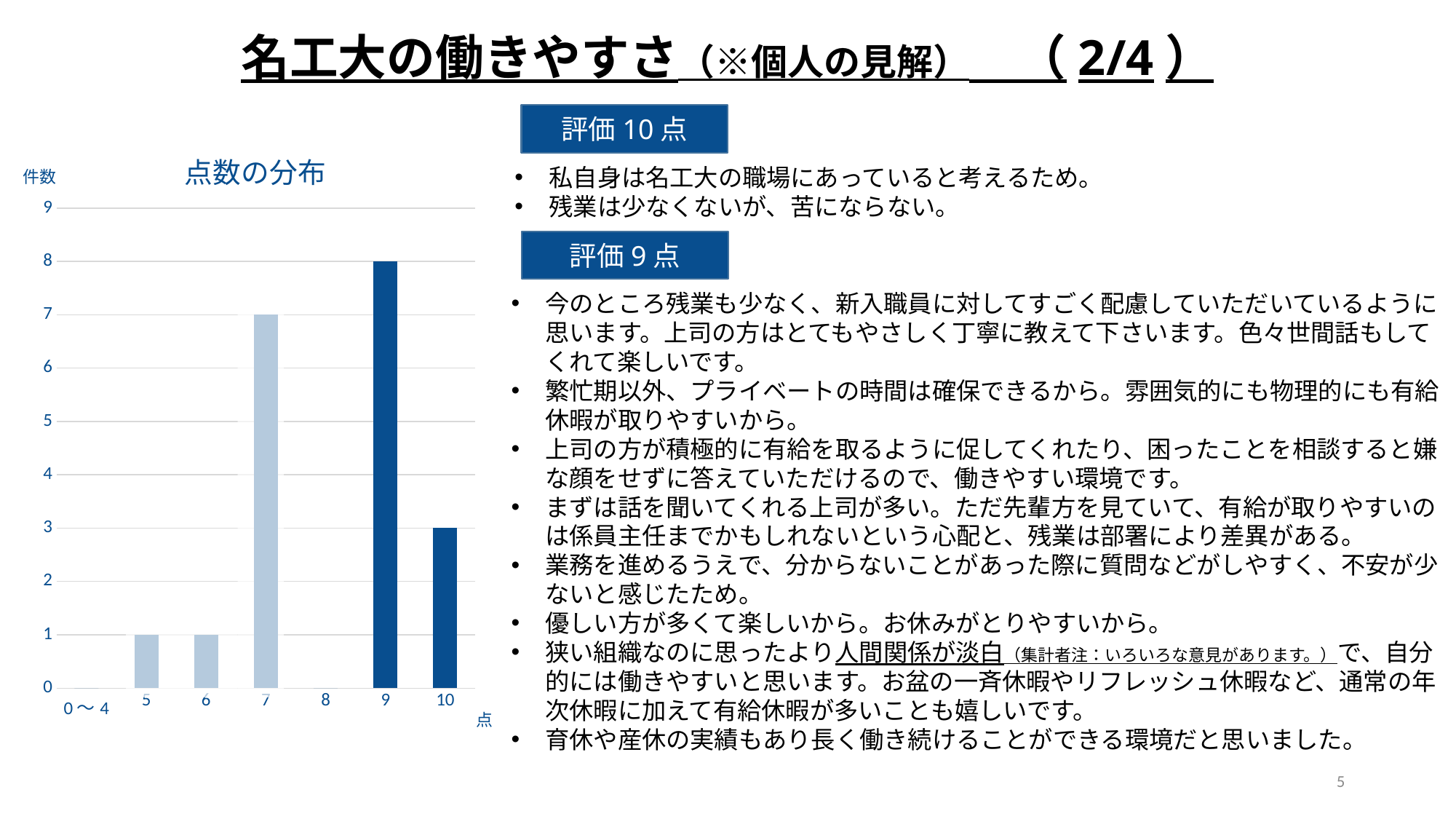
What is the count (件数) for score 10? 3 What is the title of the chart? 点数の分布 What kind of chart is shown on the slide? bar chart What is the difference between the count for score 9 and the count for score 7? 1 What is the count (件数) for score 7? 7 What is the count (件数) for score 5? 1 What is the count (件数) for score 9? 8 Which score category has the highest count in the chart? 9 How many score categories are shown on the x axis of the chart? 7 Which has a larger count, score 7 or score 10? 7 What is the label on the vertical axis of the chart? 件数 Is the count for score 9 greater or less than 5? greater